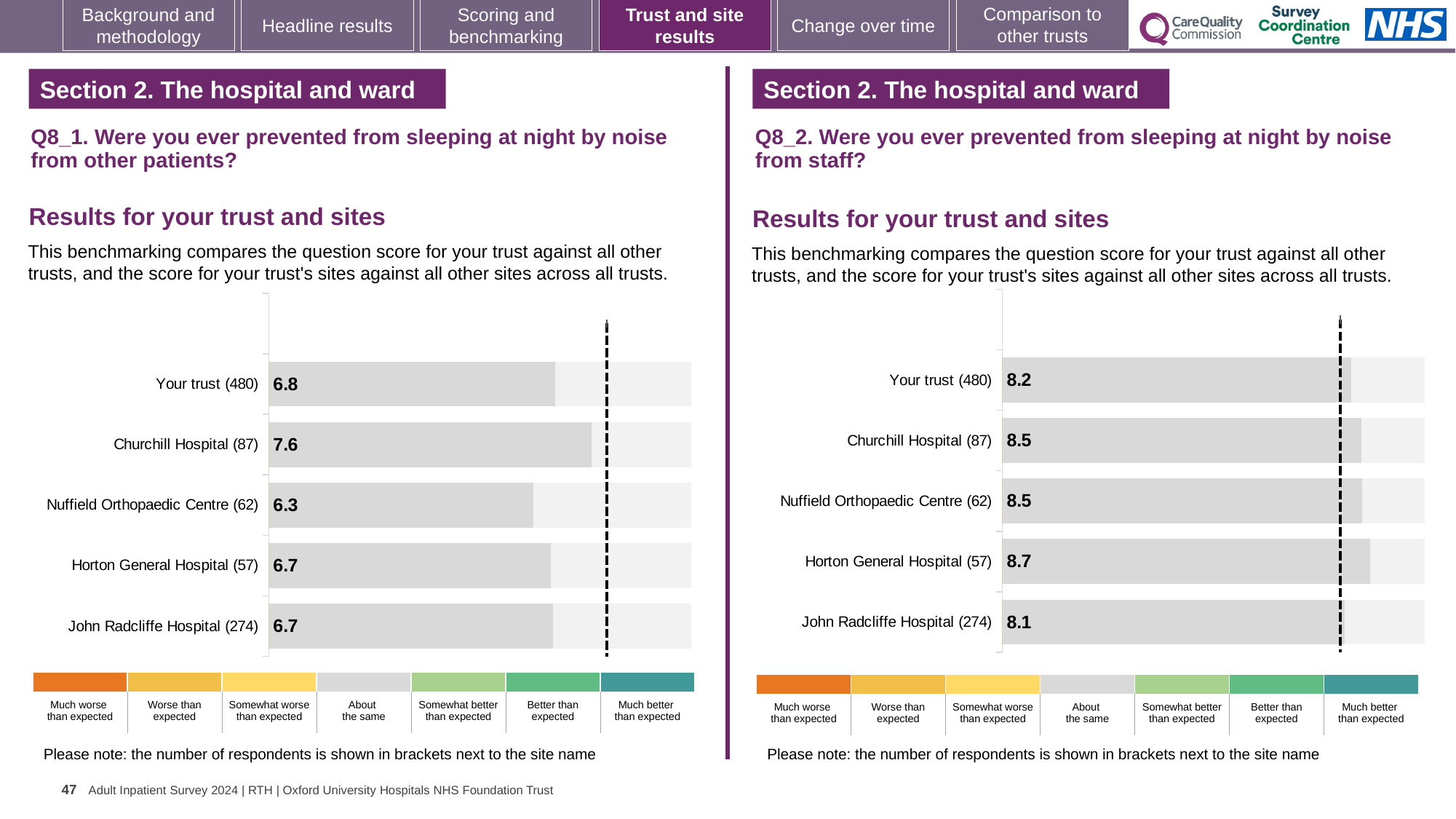
In the Q8_2 chart (noise from staff), which is larger: the score for Churchill Hospital or the score for John Radcliffe Hospital? Churchill Hospital In the Q8_1 chart (noise from other patients), which site has the lowest score? Nuffield Orthopaedic Centre In the Q8_1 chart (noise from other patients), what is the score for Nuffield Orthopaedic Centre? 6.3 In the Q8_2 chart (noise from staff), what is the difference between the Horton General Hospital score and the Your trust score? 0.5 In the Q8_1 chart (noise from other patients), what is the score for Churchill Hospital? 7.6 In the Q8_1 chart (noise from other patients), what is the difference between the Churchill Hospital score and the Your trust score? 0.8 How many bars are plotted in the Q8_1 chart (noise from other patients)? 5 What kind of chart is used in the Q8_2 chart (noise from staff)? Bar chart In the Q8_1 chart (noise from other patients), which site has the highest score? Churchill Hospital In the Q8_2 chart (noise from staff), what is the score for John Radcliffe Hospital? 8.1 In the Q8_2 chart (noise from staff), what is the score for Your trust? 8.2 In the Q8_2 chart (noise from staff), which site has the highest score? Horton General Hospital